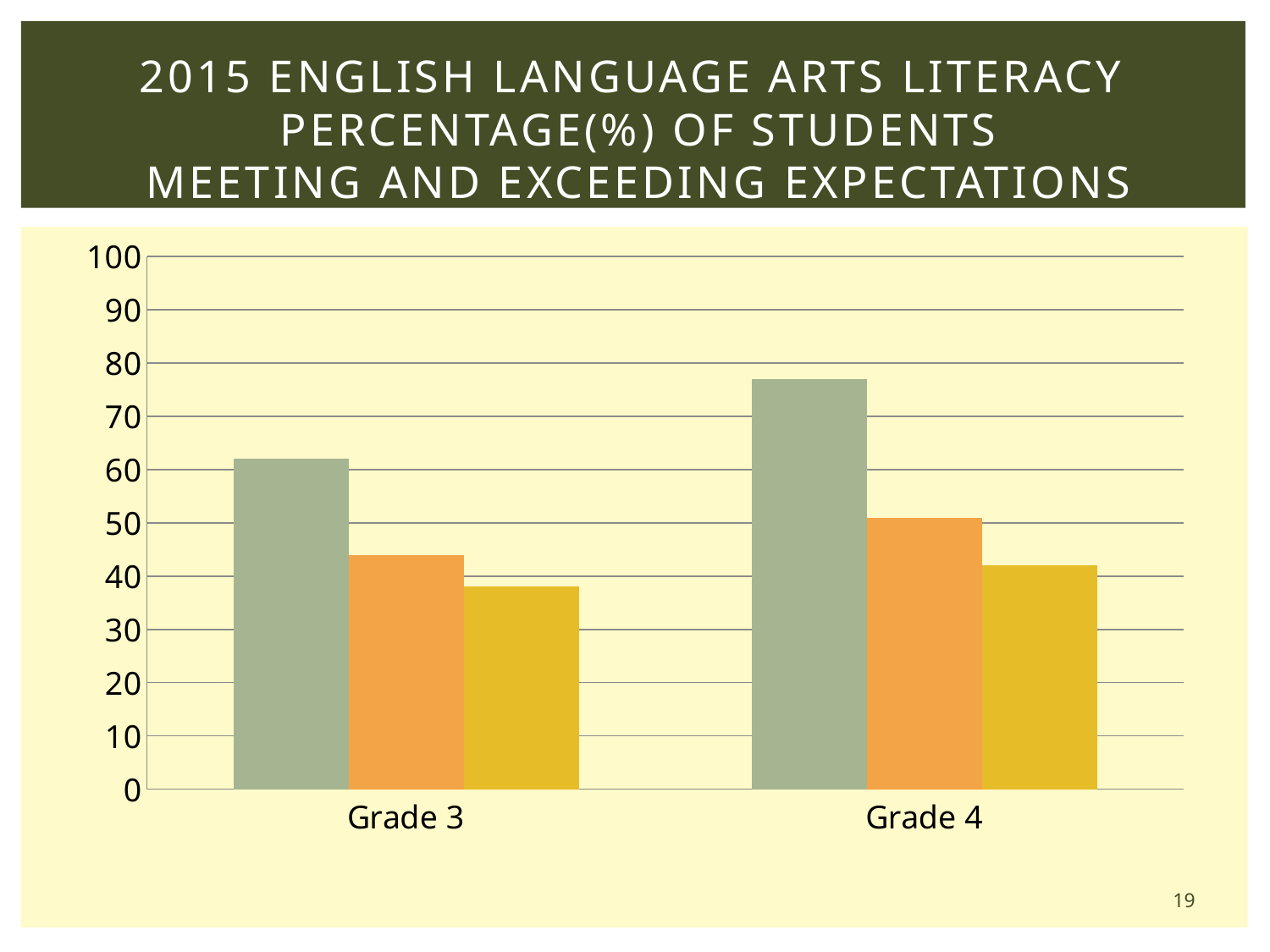
Is the value of the orange bar for Grade 3 greater or less than 50? less How many bars are plotted for each grade category? 3 How many grade categories are shown on the x axis? 2 Is the value of the orange bar for Grade 4 greater or less than 40? greater What kind of chart is shown on the slide? bar chart Is the value of the yellow bar for Grade 4 greater or less than 50? less What is the highest value shown on the vertical axis? 100 Do the values of the green-gray bars rise or fall from Grade 3 to Grade 4? rise Which grade has the tallest bar on the chart? Grade 4 Which grade has the larger green-gray bar, Grade 3 or Grade 4? Grade 4